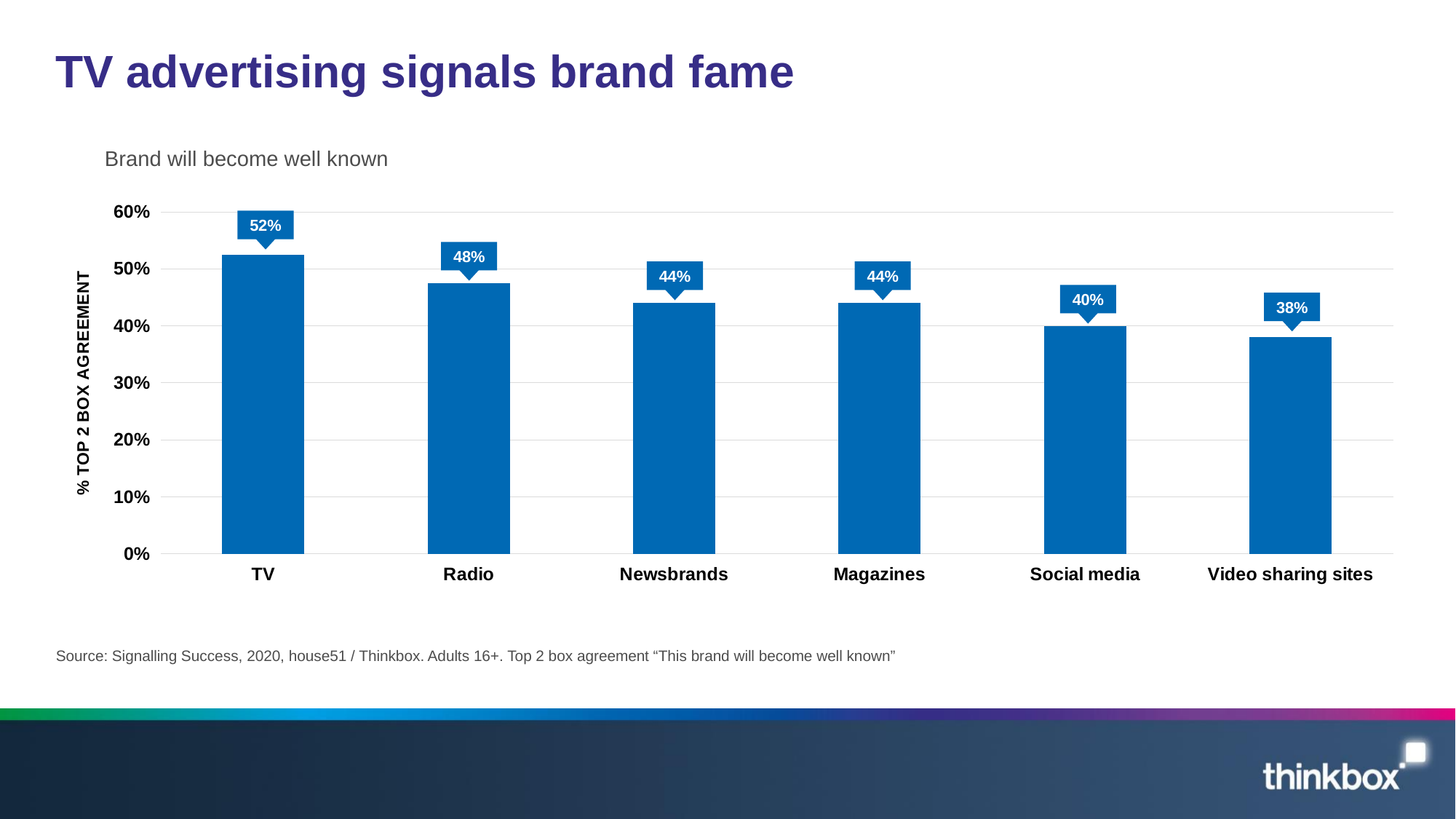
What is the label on the vertical axis? % TOP 2 BOX AGREEMENT Which category has the lowest value? Video sharing sites What is the difference between the values for Newsbrands and Video sharing sites? 6% What is the value for TV? 52% How many categories are shown on the x axis? 6 Which is larger, the value for Radio or the value for Social media? Radio What is the value for Video sharing sites? 38% What is the difference between the values for TV and Radio? 4% What is the value for Radio? 48% Which category has the highest value? TV What kind of chart is shown on the slide? Bar chart What is the value for Social media? 40%